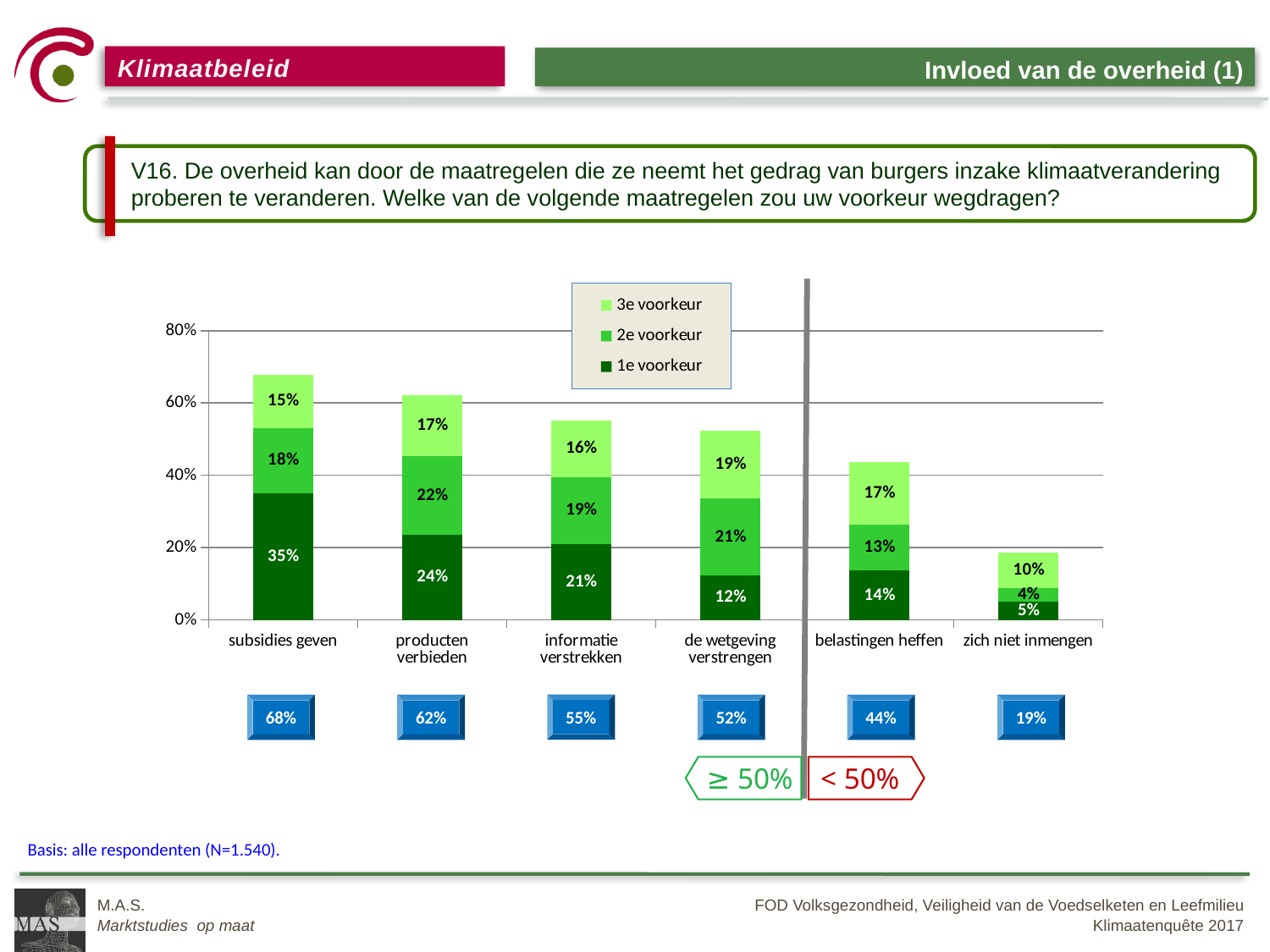
What is the value of the 2e voorkeur segment for producten verbieden? 22% How many categories are shown on the x axis? 6 What is the total of the stacked bar for zich niet inmengen? 19% What is the value of the 3e voorkeur segment for de wetgeving verstrengen? 19% How many series does the legend list? 3 What kind of chart is shown on the slide? stacked bar chart Is the top of the stacked bar for belastingen heffen greater or less than 40%? greater Which category has the highest 1e voorkeur value? subsidies geven Which has a larger 2e voorkeur value: informatie verstrekken or belastingen heffen? informatie verstrekken What is the difference between the 1e voorkeur values for subsidies geven and producten verbieden? 11 percentage points What is the value of the 1e voorkeur segment for subsidies geven? 35% Which category has the lowest stacked total? zich niet inmengen